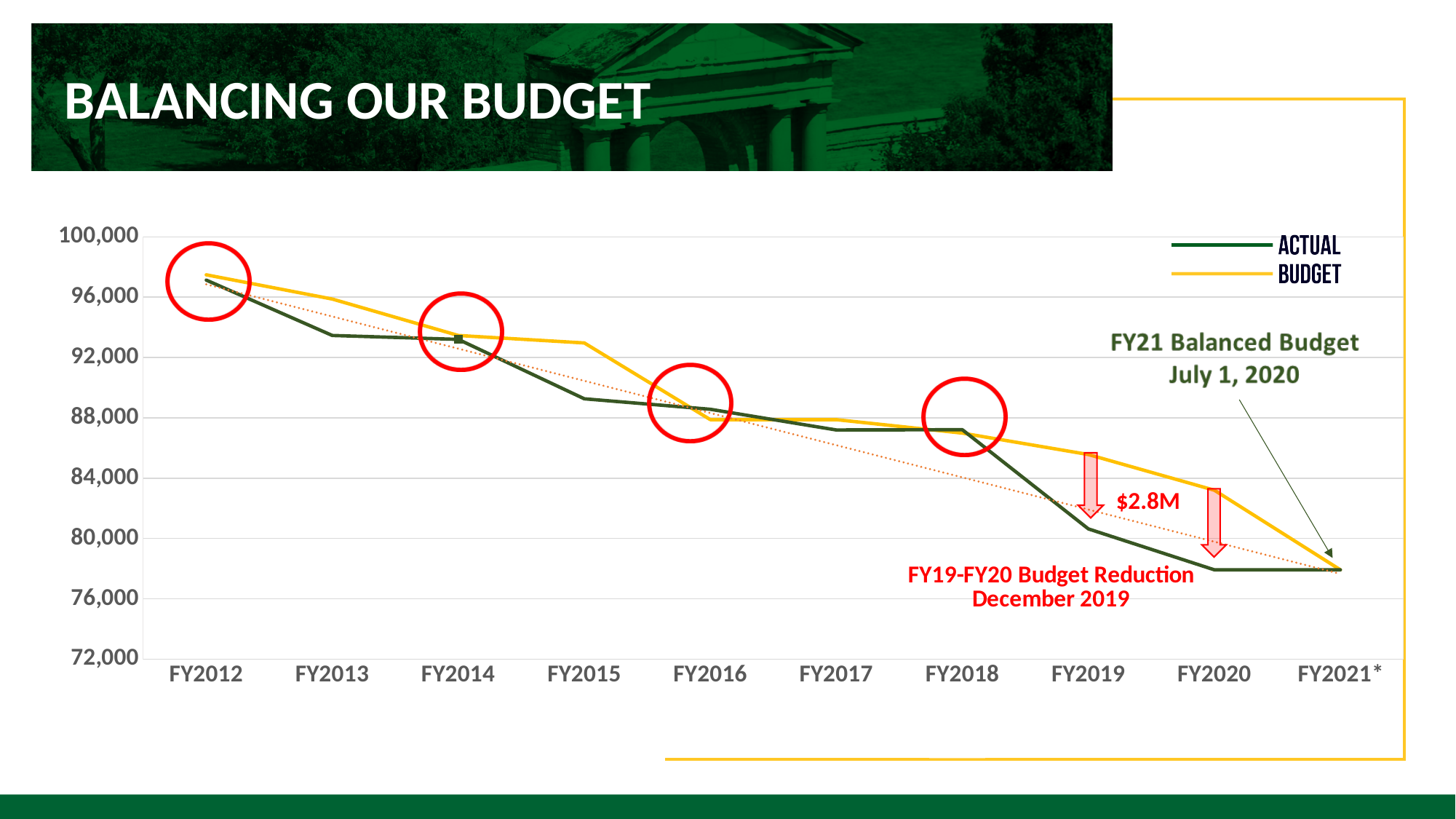
Is the BUDGET value for FY2015 greater or less than 92,000? greater What type of chart is shown on the slide? Line chart Is the ACTUAL value for FY2019 greater or less than 84,000? less How many fiscal years are shown along the x axis of the chart? 10 Is the ACTUAL value for FY2020 greater or less than 80,000? less Does the ACTUAL line generally rise or fall from FY2012 to FY2021*? Fall In FY2019, which is larger, the ACTUAL value or the BUDGET value? BUDGET How many series does the chart's legend list? 2 In which fiscal year is the ACTUAL line at its highest? FY2012 In which fiscal year is the BUDGET line at its lowest? FY2021* What are the two series named in the chart's legend? ACTUAL and BUDGET In FY2015, which is larger, the ACTUAL value or the BUDGET value? BUDGET